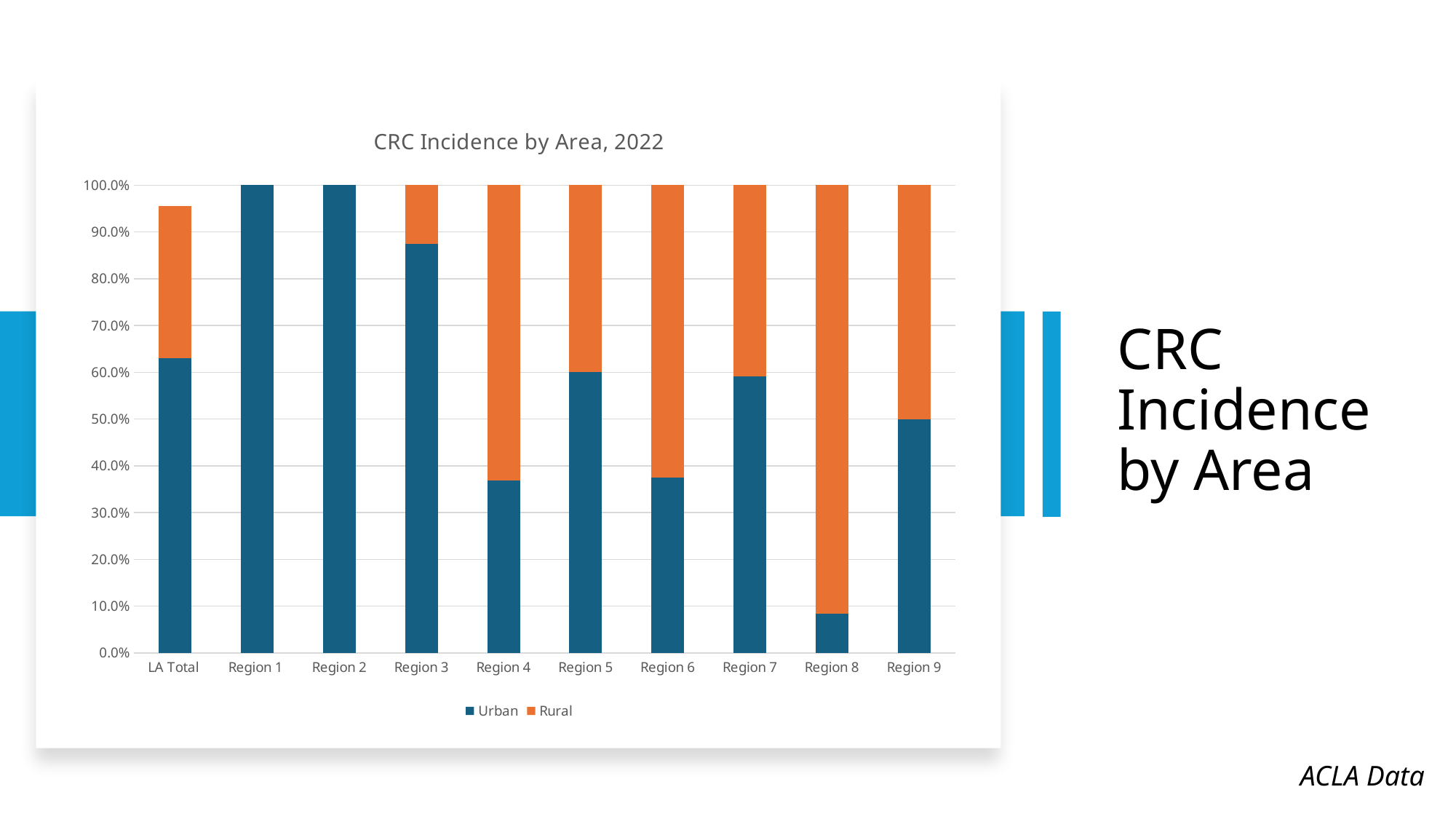
What is the title of the chart? CRC Incidence by Area, 2022 Which category has the highest Rural value? Region 8 Is the Urban value for Region 8 greater or less than 10.0%? less What is the Urban value for Region 2? 100.0% Is the Urban value for LA Total greater or less than 60.0%? greater Which category has the lowest Urban value? Region 8 Is the Urban value for Region 4 greater or less than 40.0%? less Which has the larger Urban value, Region 3 or Region 4? Region 3 How many series does the legend list? 2 What kind of chart is shown on the slide? Stacked bar chart How many categories are shown on the x axis? 10 What is the Urban value for Region 1? 100.0%